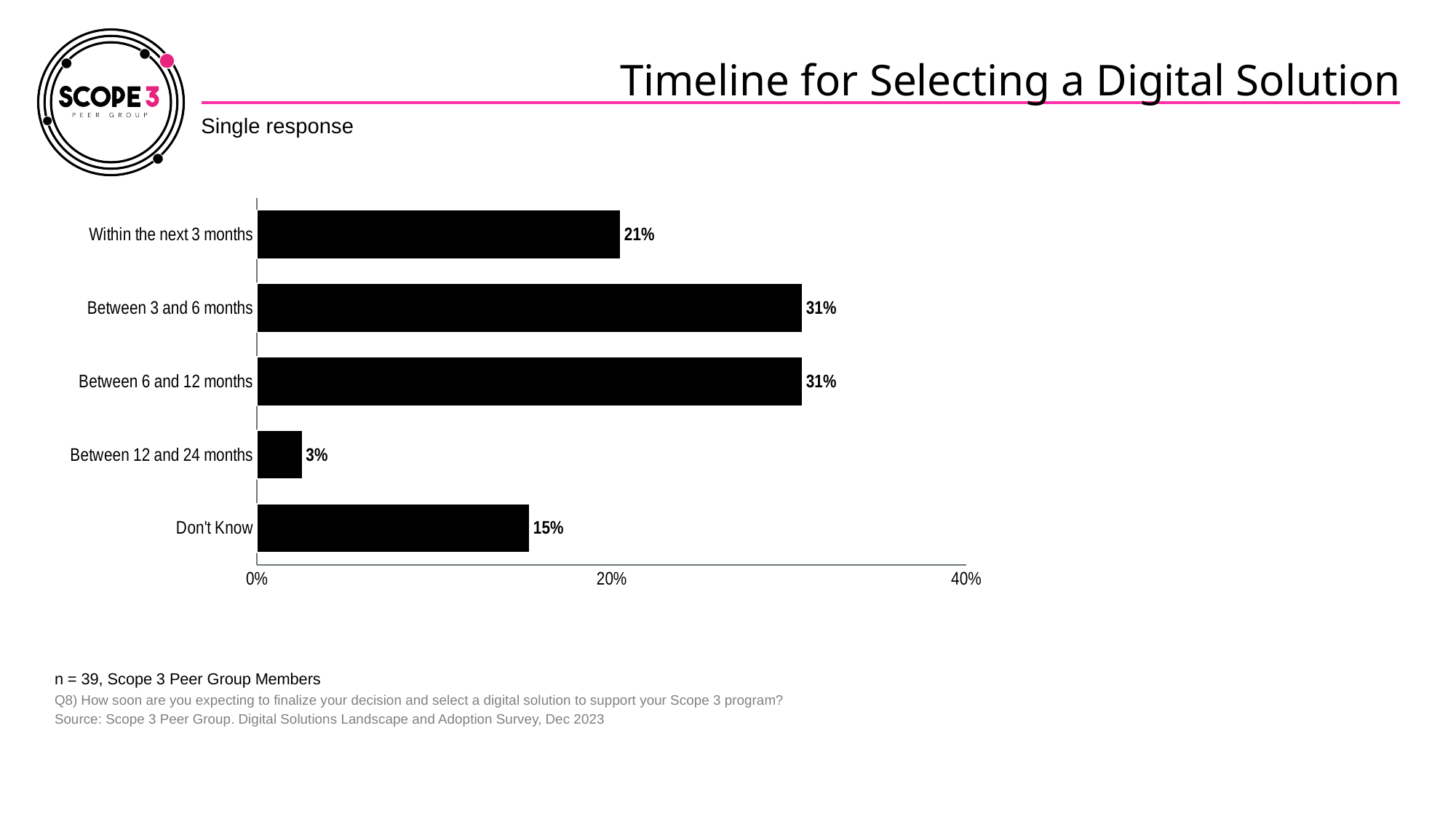
What is the title of the chart? Timeline for Selecting a Digital Solution What is the value for 'Between 12 and 24 months'? 3% What percentage of respondents answered 'Don't Know'? 15% Is the value for 'Between 3 and 6 months' greater or less than 20%? greater What kind of chart is shown on the slide? Bar chart What is the value for 'Between 6 and 12 months'? 31% How many categories are shown in the chart? 5 What percentage of respondents expect to select a digital solution within the next 3 months? 21% What is the difference between the values for 'Between 3 and 6 months' and 'Within the next 3 months'? 10% Which is larger, the value for 'Within the next 3 months' or the value for 'Don't Know'? Within the next 3 months Which category has the lowest value? Between 12 and 24 months What is the difference between the values for 'Don't Know' and 'Between 12 and 24 months'? 12%